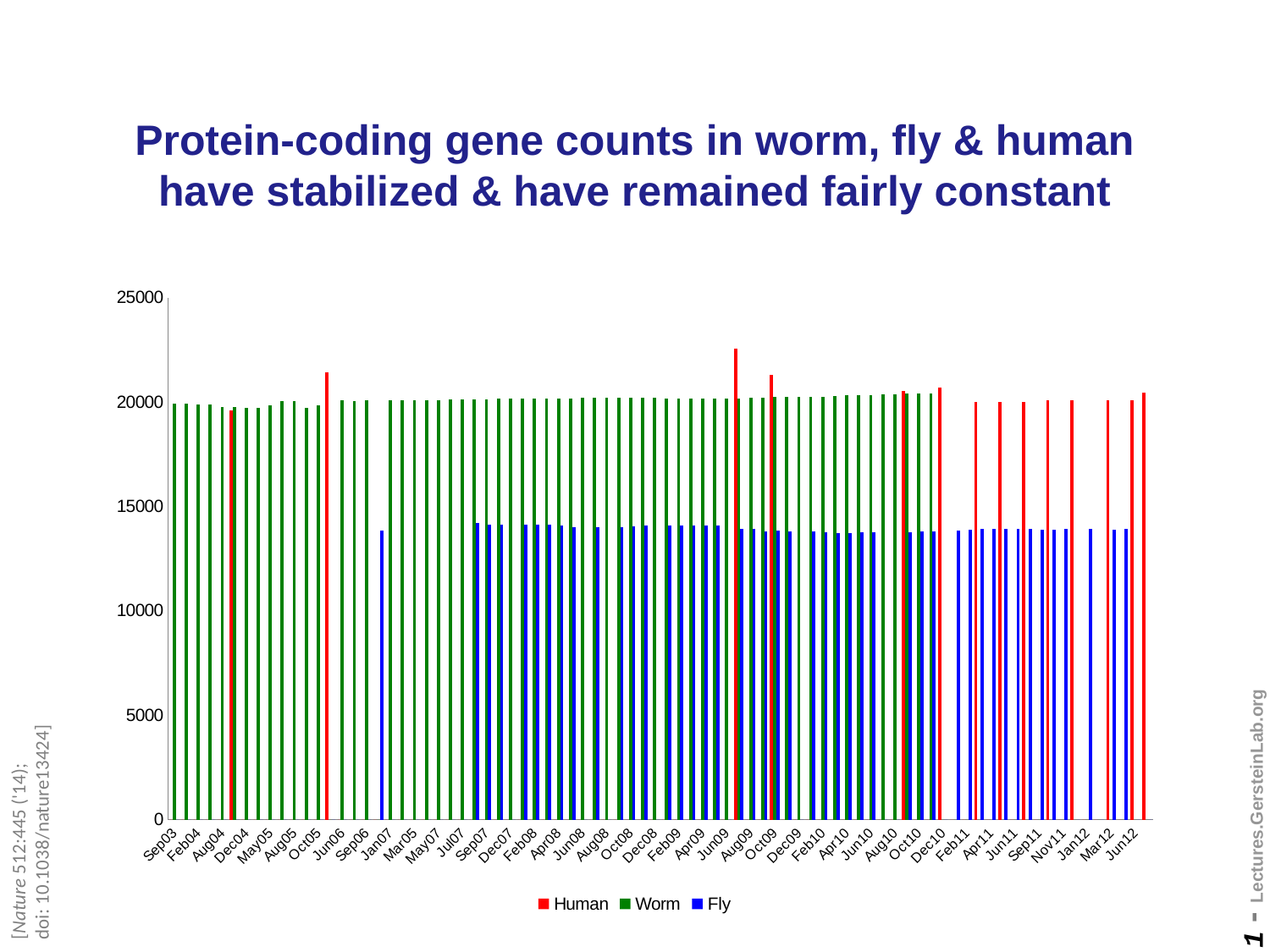
Which is larger in Jan07, the Worm value or the Fly value? Worm Is the value for Worm in Sep03 greater or less than 15000? greater Which series has the lowest values on the chart? Fly What are the three series named in the legend? Human, Worm, Fly Which series has the tallest bar on the chart? Human Which colour represents the Worm series? green Is the tallest Human bar greater or less than 20000? greater What is the highest value shown on the y axis? 25000 What kind of chart is shown on the slide? bar chart How many series does the legend list? 3